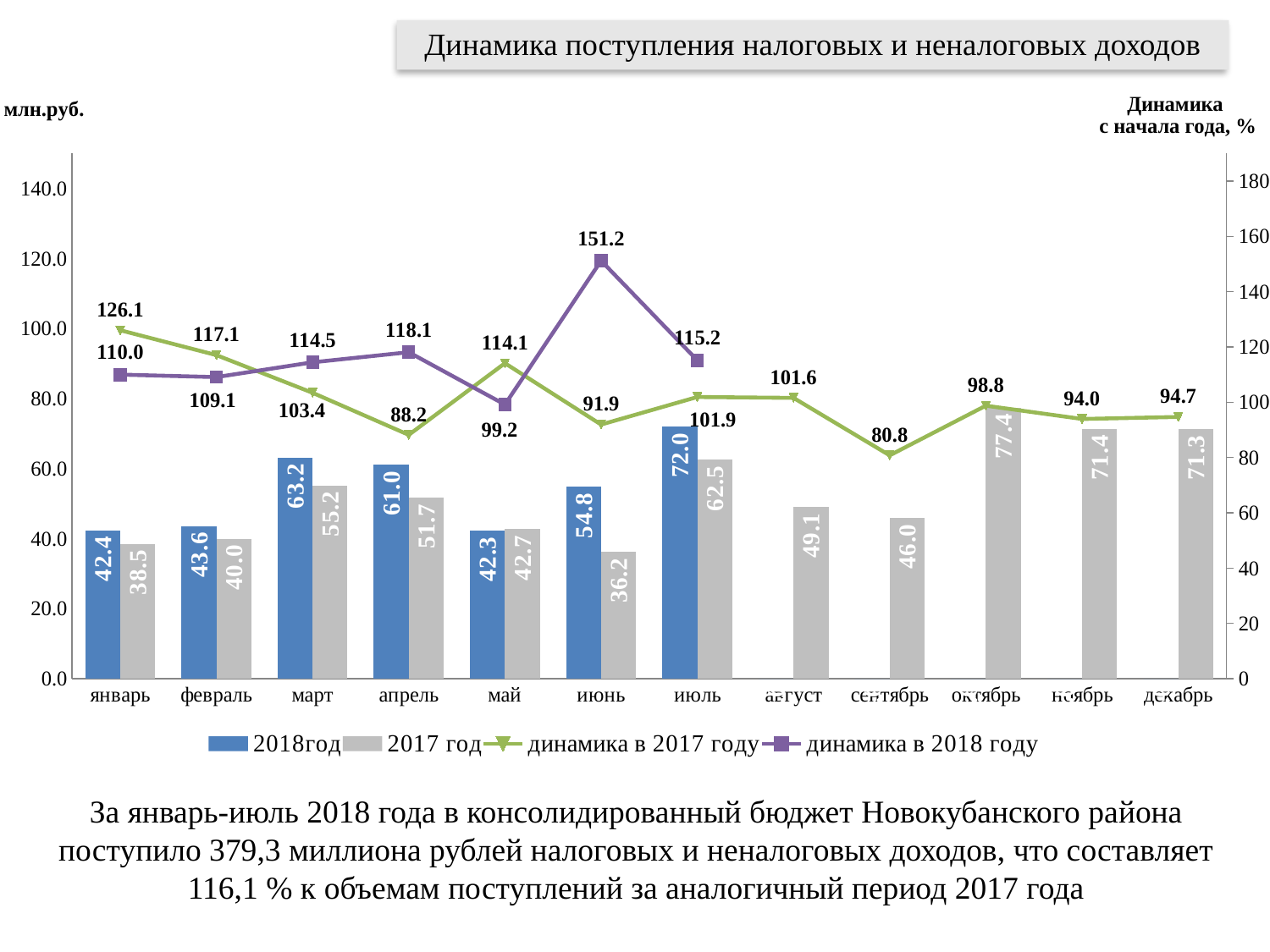
What is the value of динамика в 2017 году in сентябрь? 80.8 Which month has the highest value for 2018 год? июль Which is larger in май: the 2018 год value or the 2017 год value? 2017 год What is the value of динамика в 2018 году in июнь? 151.2 What is the title of the chart? Динамика поступления налоговых и неналоговых доходов How many months are shown on the x axis? 12 What is the value for 2018 год in июль? 72.0 Which month has the lowest value for 2017 год? июнь What kind of chart is this? Combined bar and line chart How many series does the legend list? 4 What is the difference between the 2018 год and 2017 год values in июнь? 18.6 What is the value for 2017 год in октябрь? 77.4